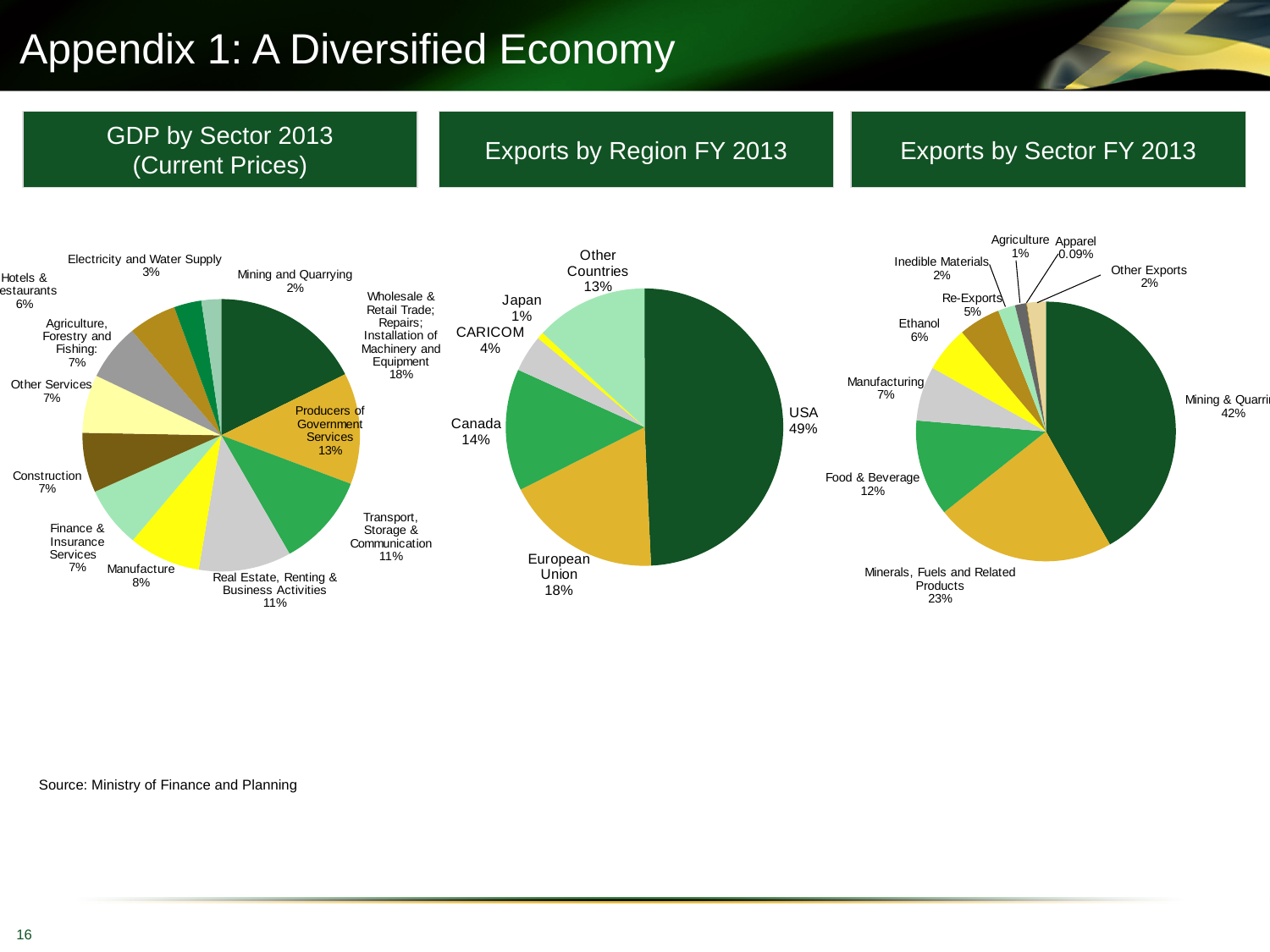
In the 'Exports by Region FY 2013' chart, what share of exports goes to the USA? 49% In the 'GDP by Sector 2013 (Current Prices)' chart, which sector has the largest share? Wholesale & Retail Trade; Repairs; Installation of Machinery and Equipment In the 'Exports by Sector FY 2013' chart, what is the share for Minerals, Fuels and Related Products? 23% What type of chart is used for 'GDP by Sector 2013 (Current Prices)'? Pie chart In the 'Exports by Sector FY 2013' chart, which sector has the largest share? Mining & Quarrying In the 'GDP by Sector 2013 (Current Prices)' chart, what is the share for Mining and Quarrying? 2% In the 'Exports by Region FY 2013' chart, what is the difference between the European Union's share and Canada's share? 4% How many regions are shown in the 'Exports by Region FY 2013' pie chart? 6 In the 'Exports by Sector FY 2013' chart, which is larger: Food & Beverage or Ethanol? Food & Beverage In the 'GDP by Sector 2013 (Current Prices)' chart, what is the share for Producers of Government Services? 13% In the 'Exports by Region FY 2013' chart, which region has the smallest share? Japan In the 'Exports by Sector FY 2013' chart, what is the share for Apparel? 0.09%